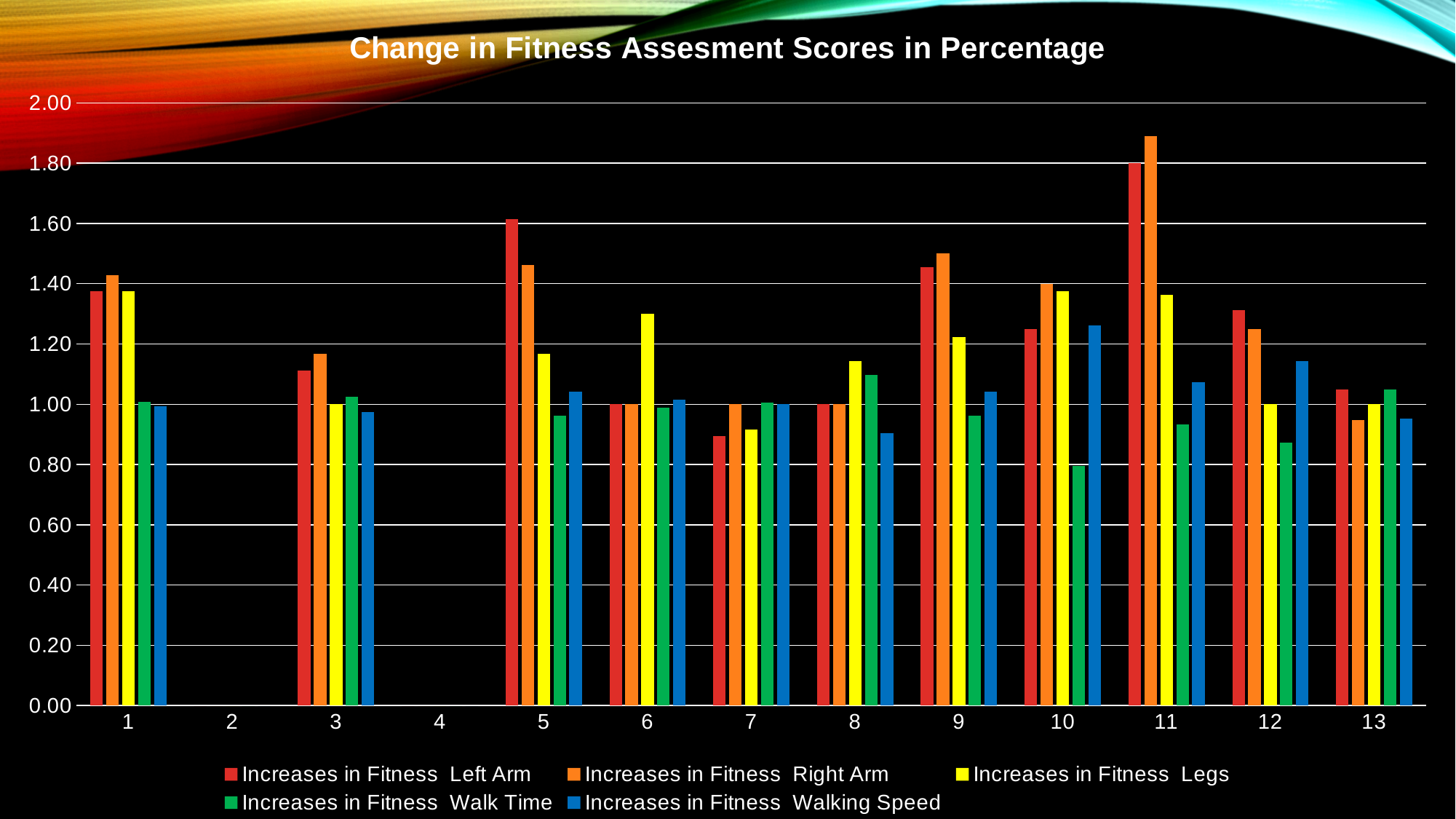
Which category has a larger Increases in Fitness Left Arm value, 3 or 5? 5 Is the Increases in Fitness Walk Time value for category 10 greater or less than 1.00? less Is the Increases in Fitness Walking Speed value for category 12 greater or less than 1.00? greater What kind of chart is shown on the slide? bar chart Which series is shown in blue in the legend? Increases in Fitness Walking Speed Is the Increases in Fitness Right Arm value for category 11 greater or less than 1.80? greater How many categories are labelled on the x axis? 13 What is the title of the chart? Change in Fitness Assesment Scores in Percentage Which category has the highest Increases in Fitness Right Arm value? 11 How many series does the legend list? 5 For category 10, which is larger: Increases in Fitness Walk Time or Increases in Fitness Walking Speed? Increases in Fitness Walking Speed